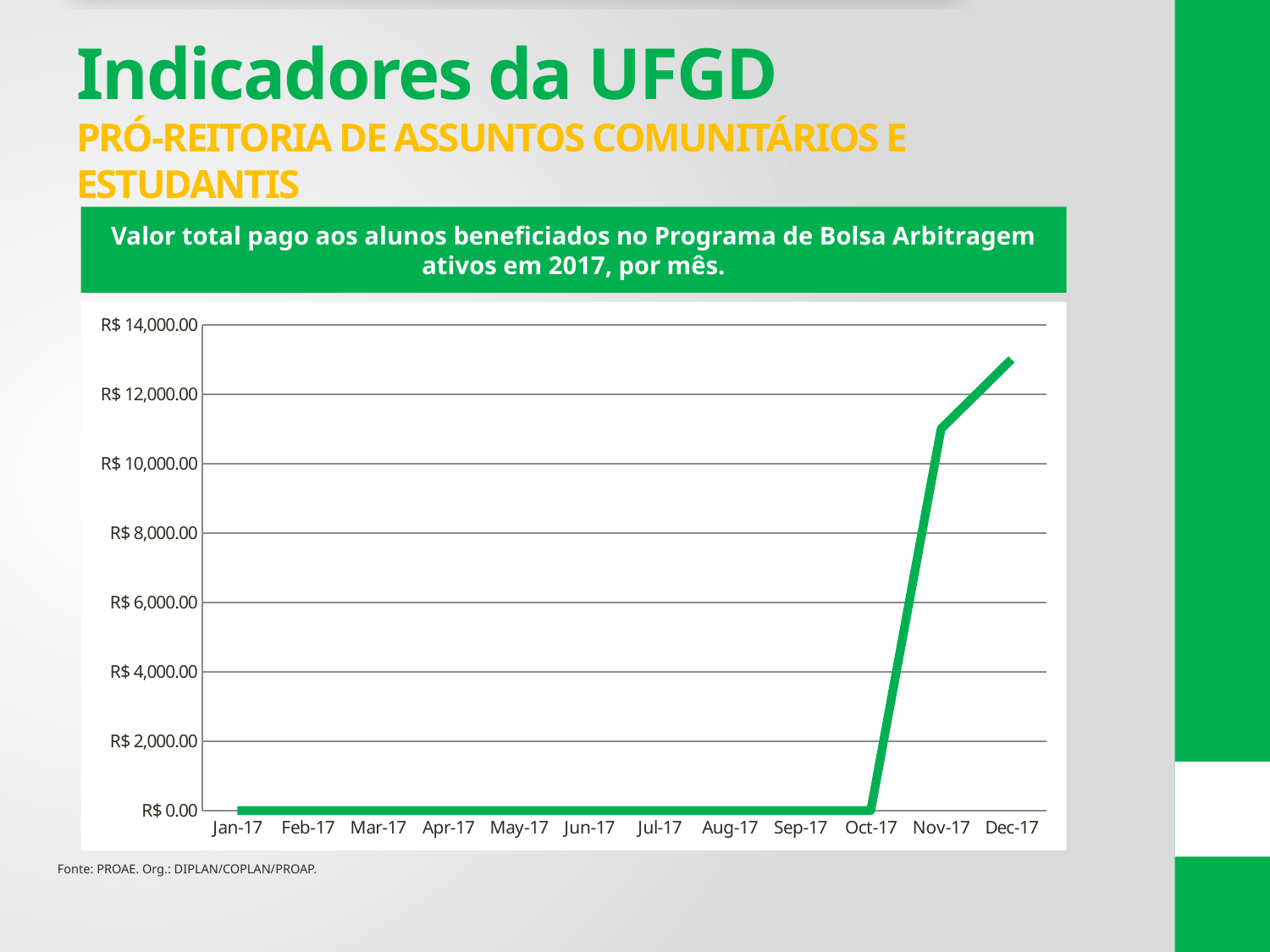
Is the value for Nov-17 greater or less than R$ 10,000.00? greater Is the value for Dec-17 greater or less than R$ 12,000.00? greater How many months in the chart have a value of R$ 0.00? 10 Do the values rise or fall from Oct-17 to Dec-17? rise Which is larger, the value for Nov-17 or the value for Dec-17? Dec-17 What is the highest tick shown on the y axis of the chart? R$ 14,000.00 Is the value for Nov-17 greater or less than R$ 12,000.00? less How many months are plotted on the x axis of the chart? 12 What is the value for Jan-17? R$ 0.00 Which month has the highest value in the chart? Dec-17 What is the value for Oct-17? R$ 0.00 What kind of chart is shown on the slide? line chart